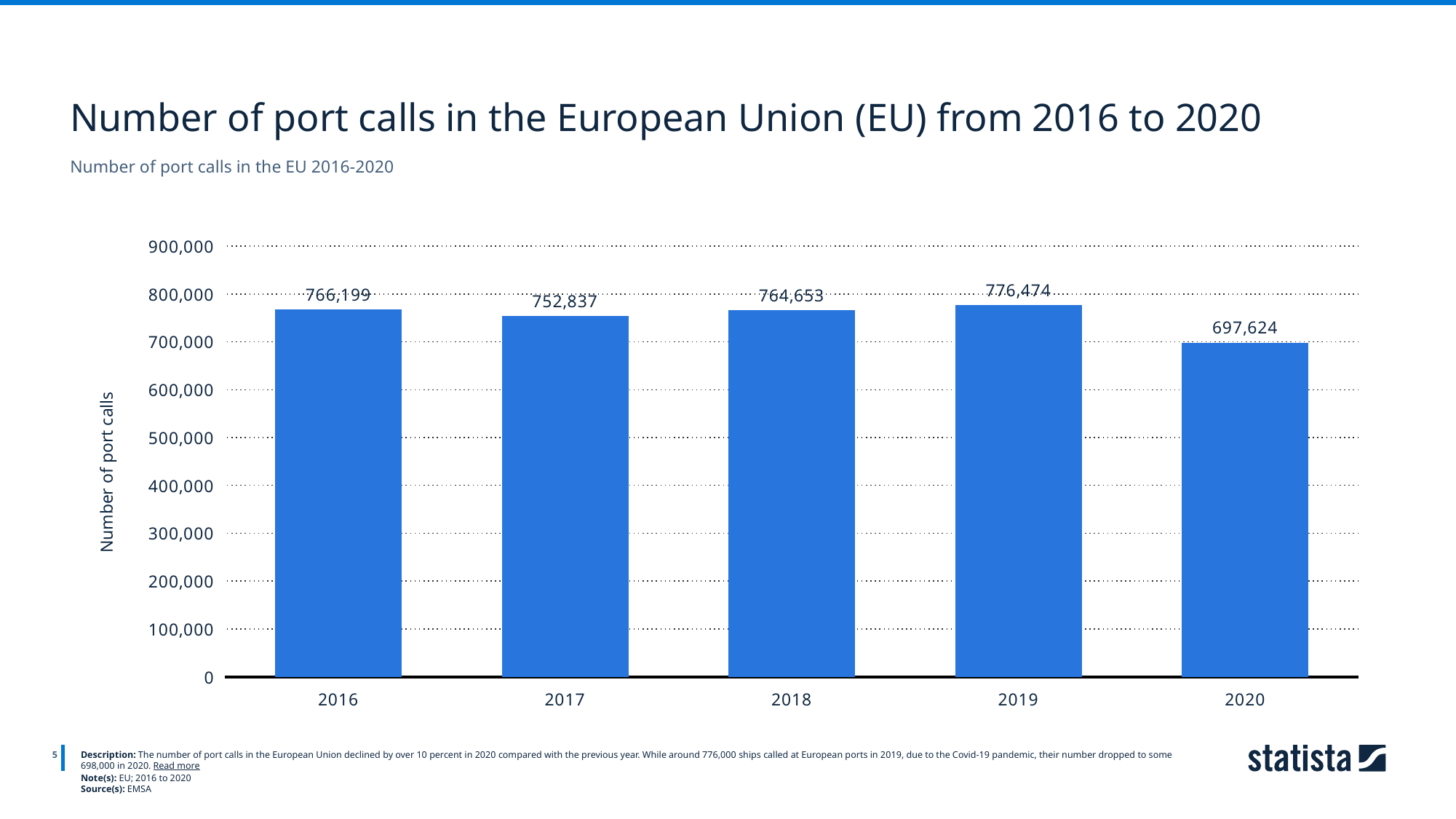
What is the number of port calls in the EU in 2018? 764,653 Which year has the lowest number of port calls? 2020 What is the difference in port calls between 2019 and 2020? 78,850 Did the number of port calls rise or fall from 2019 to 2020? fall Which year had more port calls, 2017 or 2019? 2019 What is the number of port calls in the EU in 2016? 766,199 What kind of chart is shown on the slide? bar chart What is the number of port calls in the EU in 2020? 697,624 Is the value for 2020 greater or less than 700,000? less How many years are shown on the x axis? 5 Which year has the highest number of port calls? 2019 What is the difference in port calls between 2016 and 2017? 13,362